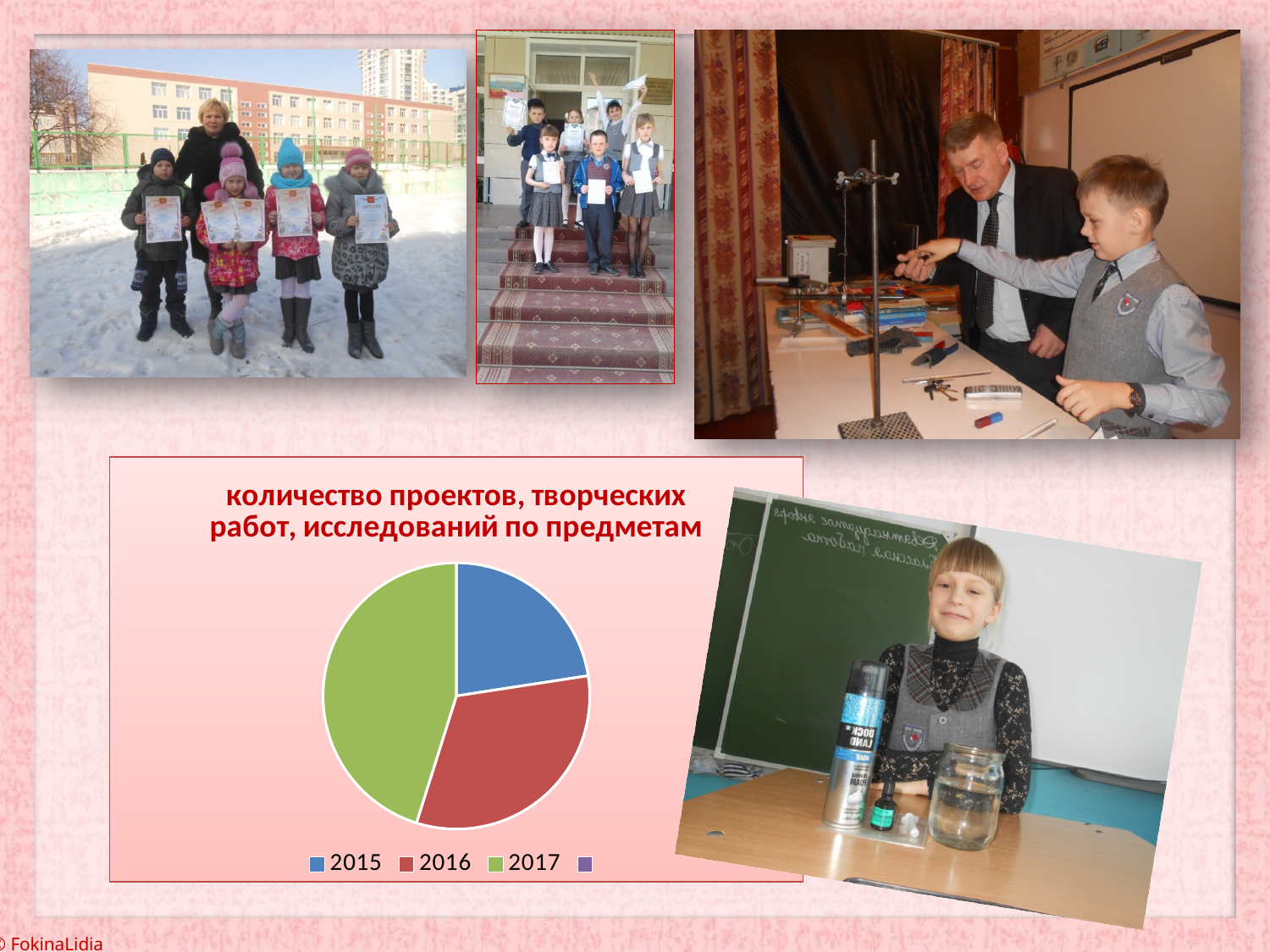
Which colour represents 2017 in the pie chart? green What kind of chart is shown on the slide? pie chart Which year has the largest slice in the pie chart? 2017 Which year has the smallest slice in the pie chart? 2015 Which slice is larger in the pie chart, 2017 or 2016? 2017 Which slice is larger in the pie chart, 2016 or 2015? 2016 What is the title of the pie chart? количество проектов, творческих работ, исследований по предметам Which years are named in the legend of the pie chart? 2015, 2016, 2017 How many slices are visible in the pie chart? 3